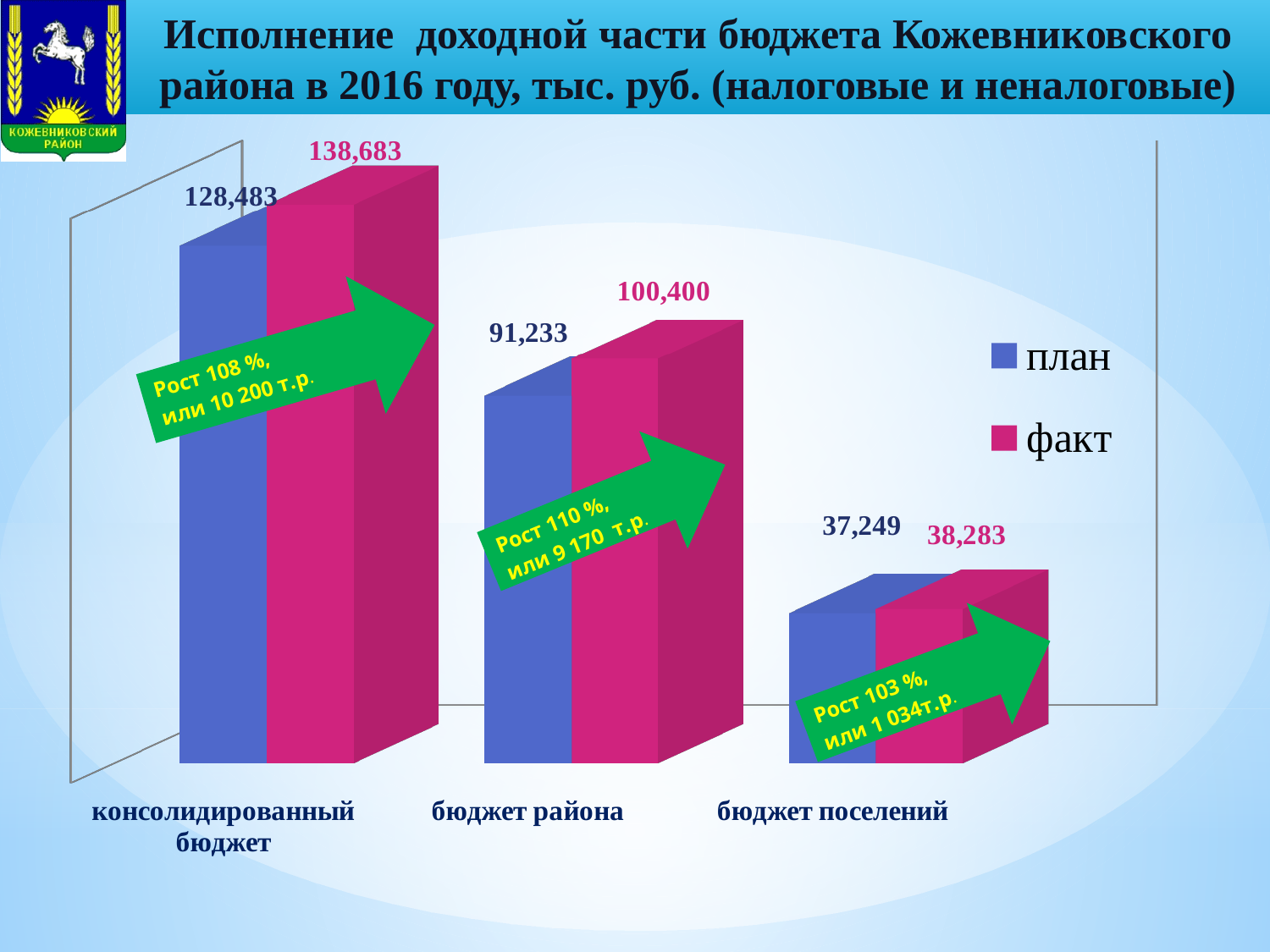
What is the факт value for консолидированный бюджет? 138,683 How many categories are shown on the x axis? 3 What kind of chart is shown on the slide? bar chart What is the difference between факт and план for бюджет поселений? 1,034 What is the difference between факт and план for консолидированный бюджет? 10,200 What is the план value for бюджет района? 91,233 What is the факт value for бюджет поселений? 38,283 How many series does the legend list? 2 Which is larger for бюджет района, план or факт? факт What is the план value for консолидированный бюджет? 128,483 Which category has the lowest план value? бюджет поселений Which category has the highest факт value? консолидированный бюджет